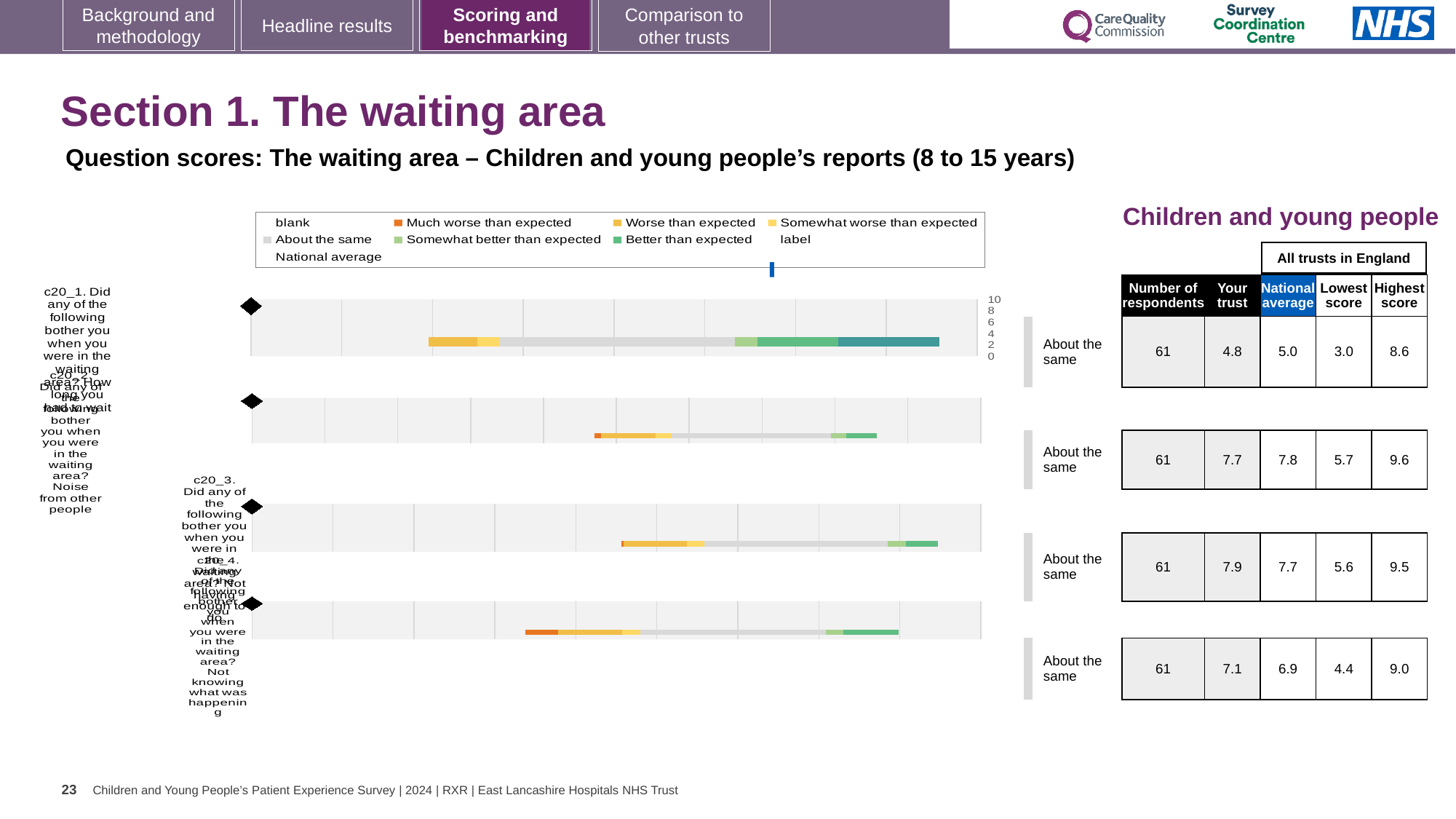
What does the blue marker in the chart legend represent? National average In the table next to the chart, how many respondents are listed for the third row (c20_3)? 61 In the chart legend, what colour represents 'Much worse than expected'? orange In the table next to the chart, what is the highest score across all trusts in England for the second row (c20_2)? 9.6 Which row in the table has the lowest 'Your trust' score? c20_1 (4.8) Which row in the table has the highest 'Your trust' score? c20_3 (7.9) For the third row (c20_3), what is the difference between the 'Your trust' score (7.9) and the national average (7.7)? 0.2 For the fourth row (c20_4), which is larger: the 'Your trust' score or the national average? Your trust (7.1) In the table next to the chart, what is the 'Your trust' score for the first row (c20_1, bother in the waiting area)? 4.8 How many horizontal bars (questions) are plotted in the chart? 4 What kind of chart is shown on the slide? bar chart In the table next to the chart, what is the national average for the first row (c20_1)? 5.0